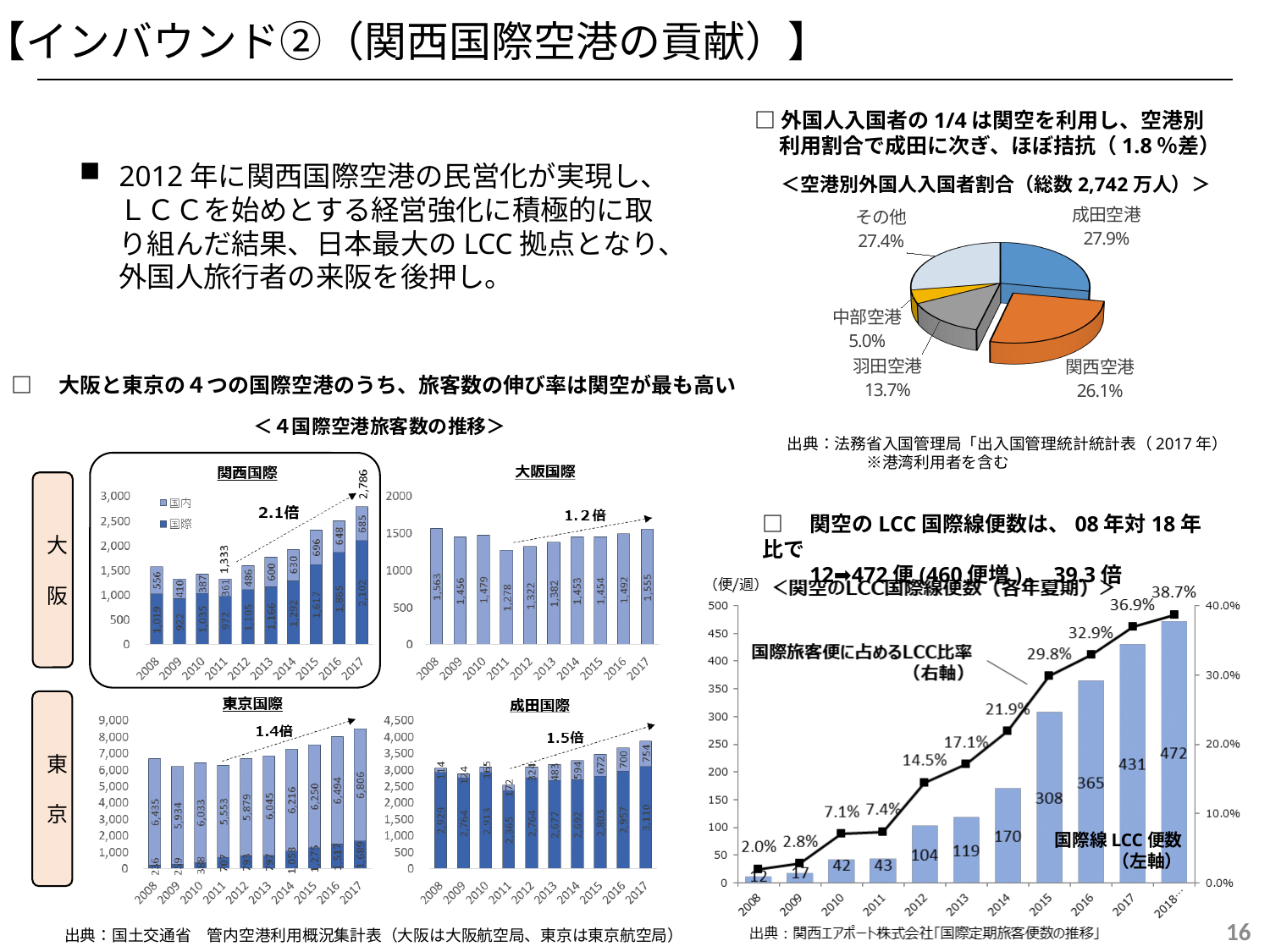
In the chart titled 関空のLCC国際線便数（各年夏期）, what is the difference between the 2018 and 2008 bar values? 460 In the chart titled 関空のLCC国際線便数（各年夏期）, what LCC share (line) is shown for 2014? 21.9% In the chart titled 大阪国際, which year has the lowest value? 2011 In the pie chart titled 空港別外国人入国者割合, what share is shown for 関西空港? 26.1% In the chart titled 関空のLCC国際線便数（各年夏期）, do the bar values rise or fall from 2008 to 2018? rise In the pie chart titled 空港別外国人入国者割合, what is the difference between the 成田空港 share and the 関西空港 share? 1.8% What kind of chart is the 関西国際 chart on the left of the slide? bar chart In the chart titled 大阪国際, what is the value for 2011? 1,278 In the chart titled 関空のLCC国際線便数（各年夏期）, what is the number of LCC international flights (bar) for 2018? 472 In the pie chart titled 空港別外国人入国者割合, which airport slice is the smallest? 中部空港 In the chart titled 大阪国際, is the value for 2008 greater or less than 1,500? greater In the pie chart titled 空港別外国人入国者割合, how many slices are there? 5